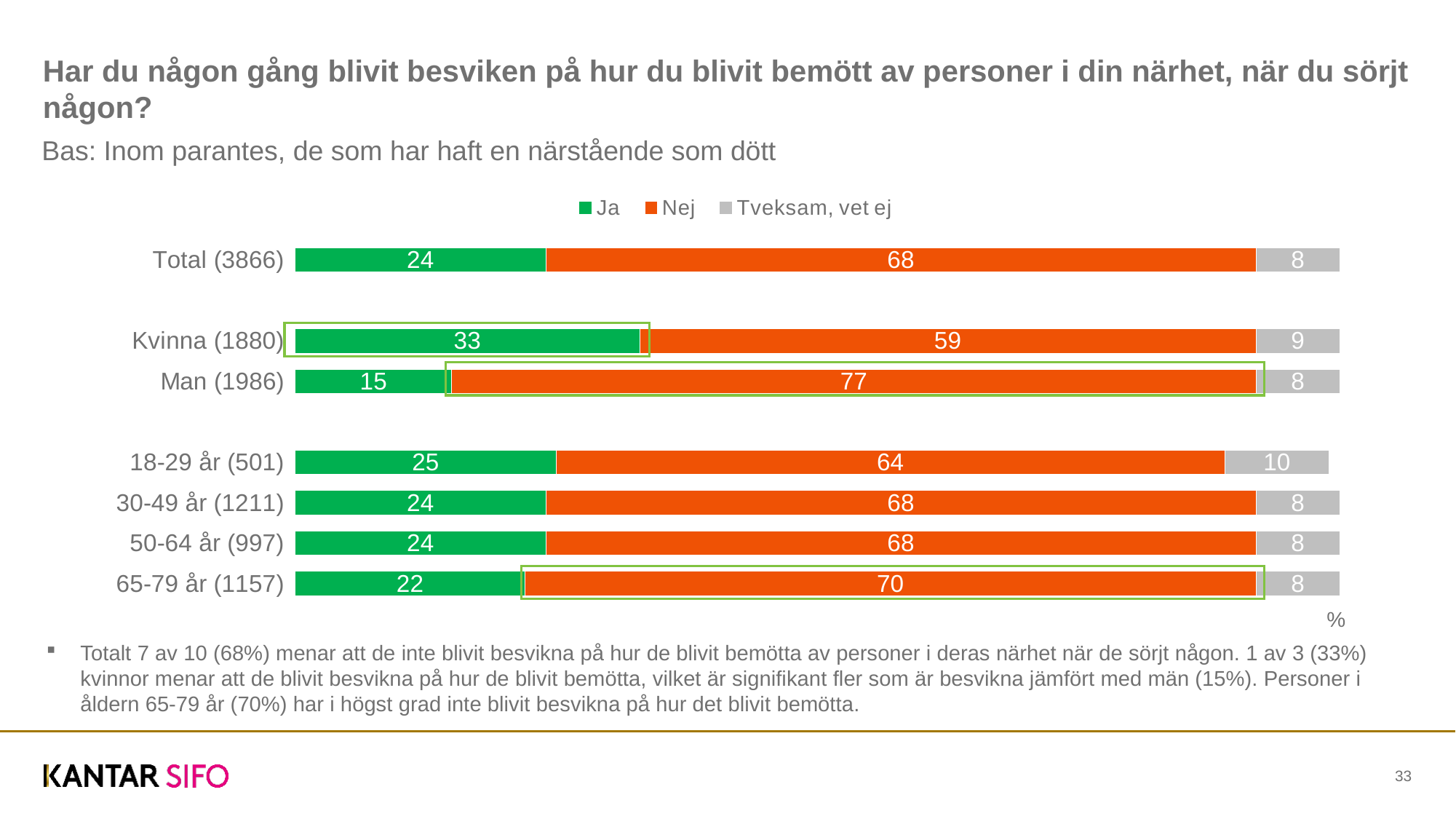
Which is larger, the "Nej" value for 65-79 år (1157) or for 18-29 år (501)? 65-79 år (1157) Which category has the lowest "Ja" value? Man (1986) What kind of chart is shown on the slide? Stacked bar chart What is the "Nej" value for Man (1986)? 77 Which category has the highest "Ja" value? Kvinna (1880) What is the "Tveksam, vet ej" value for 18-29 år (501)? 10 Which series is shown in orange in the legend? Nej What is the "Ja" value for Kvinna (1880)? 33 What is the total of the stacked bar for Total (3866)? 100 How many categories are shown in the chart? 7 What is the difference between the "Ja" values for Kvinna (1880) and Man (1986)? 18 How many series does the legend list? 3